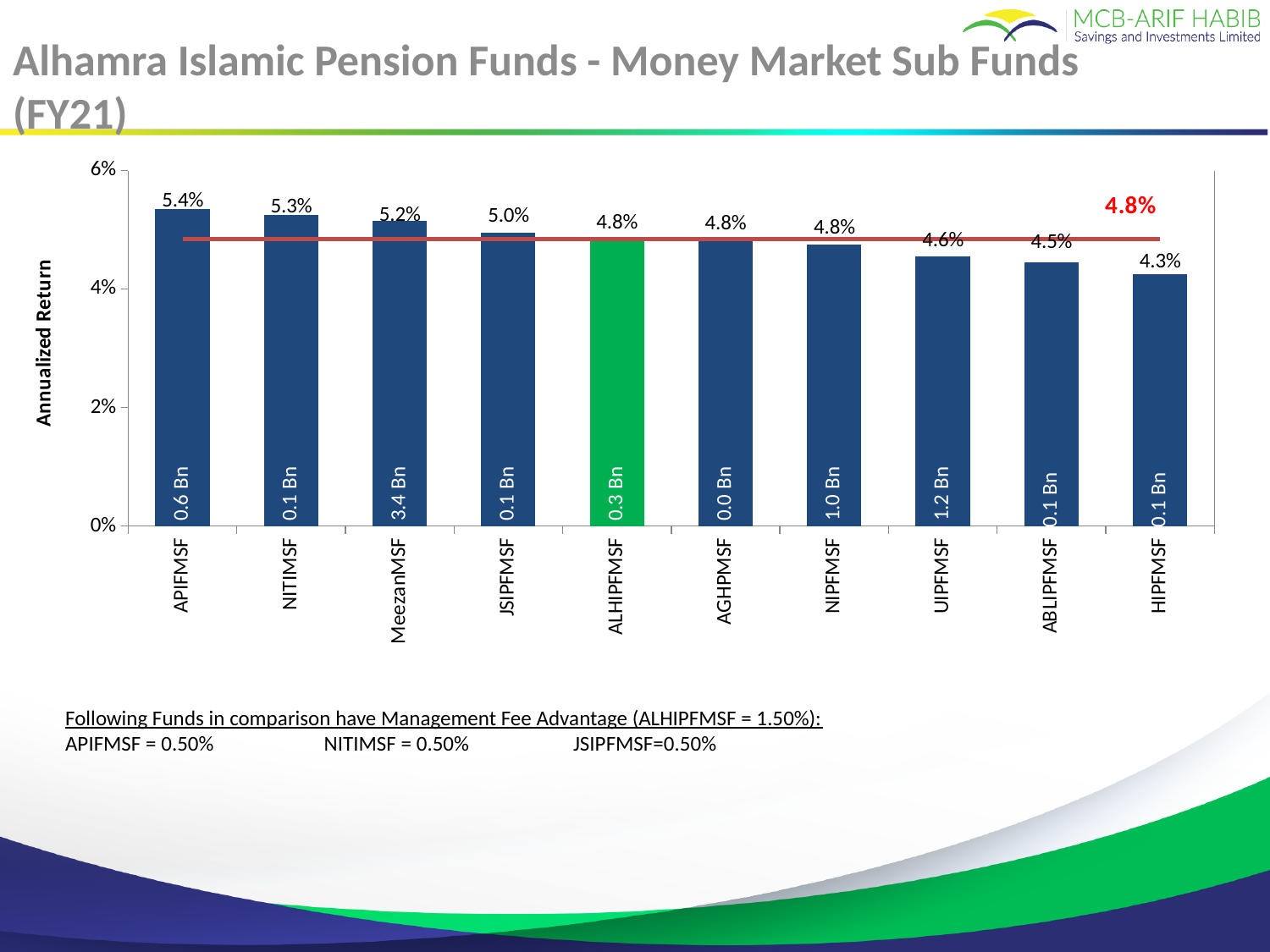
What value is labelled on the red horizontal line across the chart? 4.8% What is the difference between the annualized returns of APIFMSF and HIPFMSF? 1.1% Which has the higher annualized return, NITIMSF or UIPFMSF? NITIMSF What fund size label is printed inside the MeezanMSF bar? 3.4 Bn How many funds are plotted on the chart? 10 Which fund has the highest annualized return? APIFMSF What is the annualized return shown for APIFMSF? 5.4% Which fund has the lowest annualized return? HIPFMSF Do the annualized returns rise or fall moving from left to right along the x axis? fall What is the annualized return shown for ALHIPFMSF? 4.8% What type of chart is shown on the slide? bar chart Is the annualized return for JSIPFMSF greater or less than 4%? greater